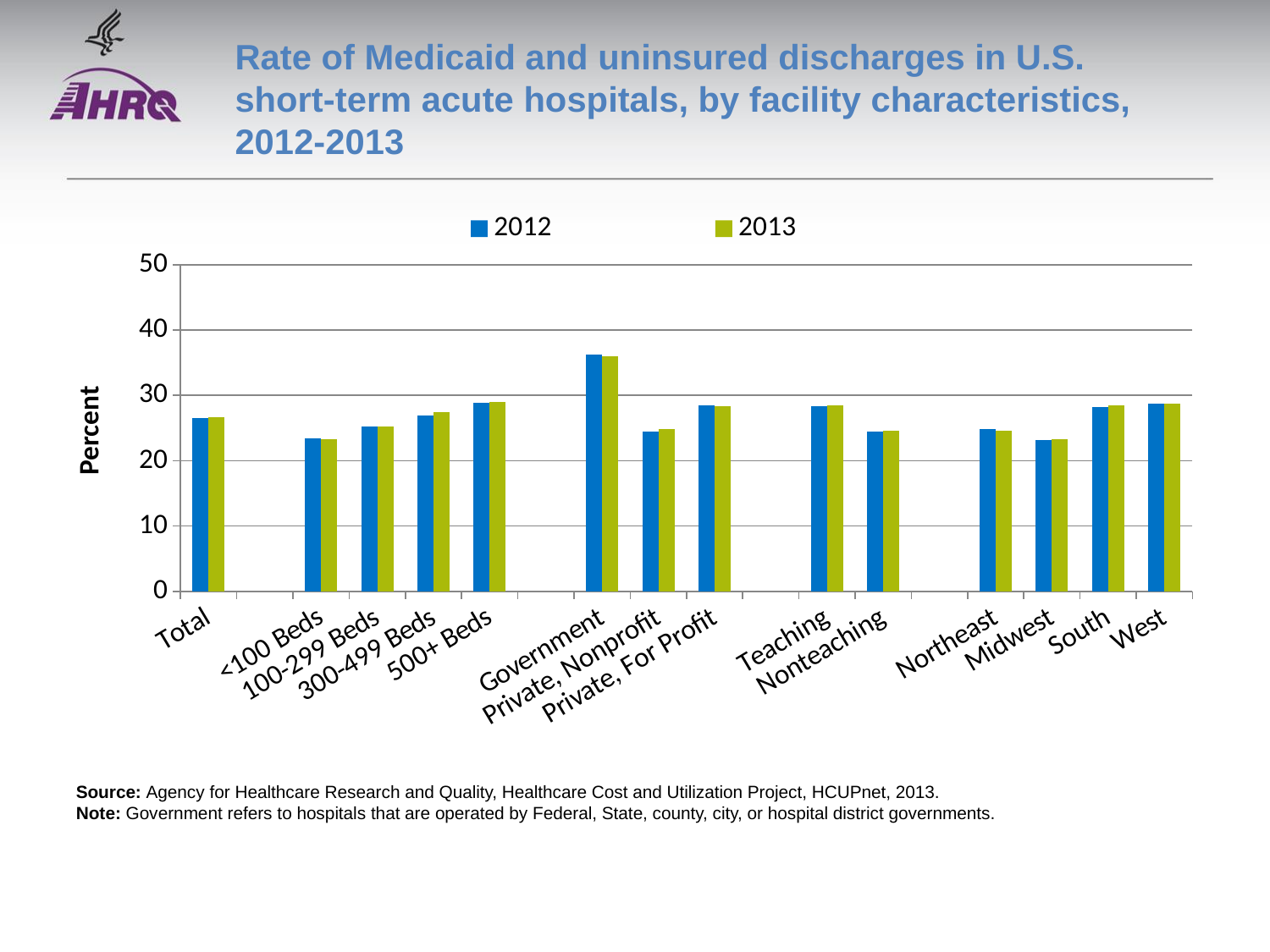
Which category has the highest rate of Medicaid and uninsured discharges in 2012? Government In 2013, which is larger: the value for Teaching or the value for Nonteaching? Teaching How many facility characteristic categories are shown on the x axis? 14 Is the 2013 value for Total greater or less than 20? greater How many series does the legend list? 2 Which years are listed in the legend? 2012 and 2013 In 2012, which is larger: the value for Government or the value for Private, Nonprofit? Government Is the 2012 value for Government greater or less than 30? greater What kind of chart is shown on the slide? bar chart Is the 2013 value for Midwest greater or less than 30? less Which category has the highest rate of Medicaid and uninsured discharges in 2013? Government